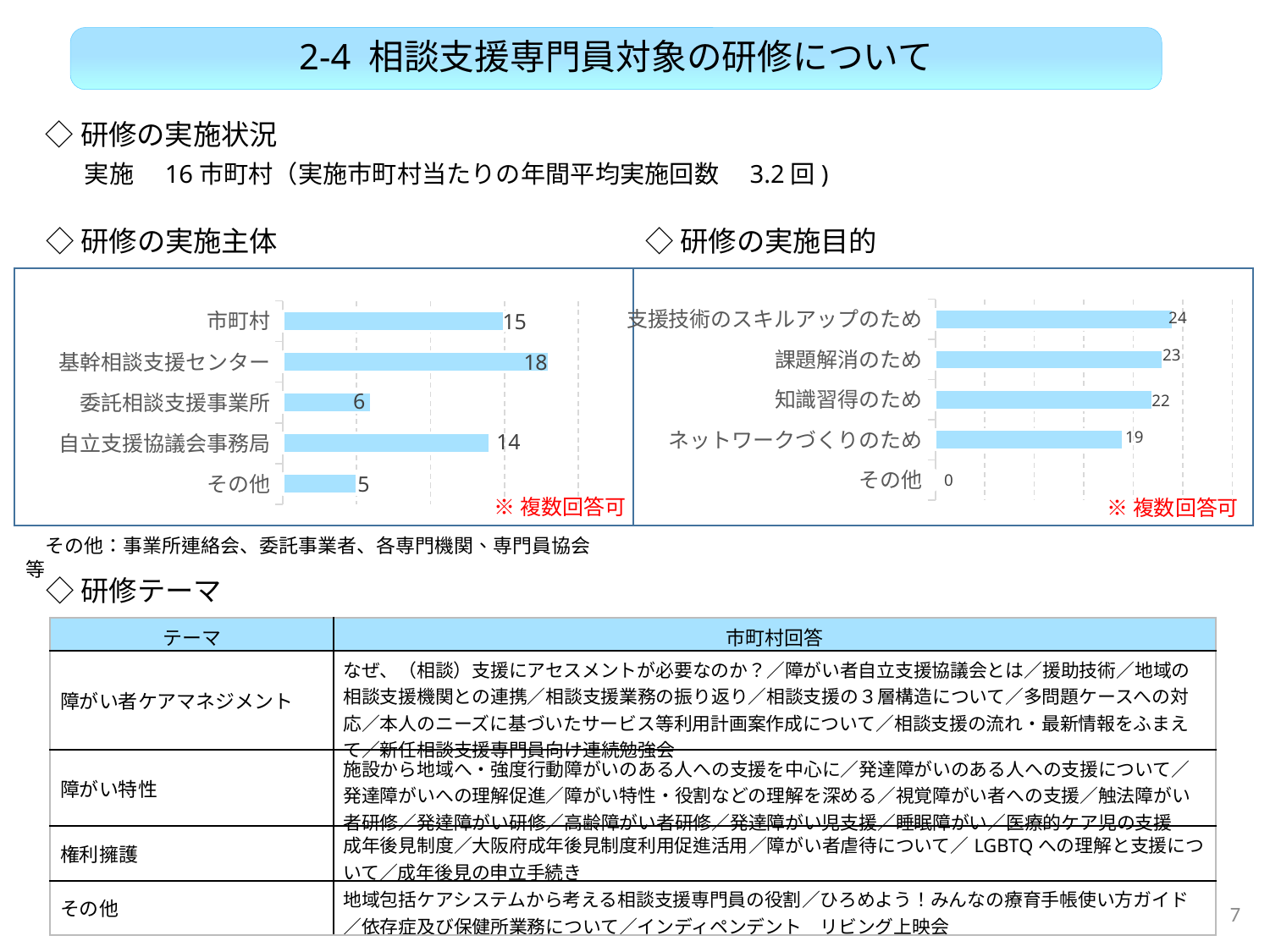
What type of chart is the 研修の実施目的 chart (right)? Bar chart In the 研修の実施主体 chart (left), how many categories are shown? 5 In the 研修の実施目的 chart (right), what is the value for その他? 0 In the 研修の実施主体 chart (left), which category has the highest value? 基幹相談支援センター In the 研修の実施主体 chart (left), what is the value for 基幹相談支援センター? 18 In the 研修の実施目的 chart (right), which category has the highest value? 支援技術のスキルアップのため In the 研修の実施目的 chart (right), what is the value for ネットワークづくりのため? 19 In the 研修の実施目的 chart (right), what is the difference between the values for 支援技術のスキルアップのため and 知識習得のため? 2 In the 研修の実施主体 chart (left), which category has the lowest value? その他 In the 研修の実施主体 chart (left), what is the difference between the values for 市町村 and 自立支援協議会事務局? 1 In the 研修の実施主体 chart (left), what is the value for 委託相談支援事業所? 6 In the 研修の実施目的 chart (right), which is larger, the value for 課題解消のため or the value for ネットワークづくりのため? 課題解消のため